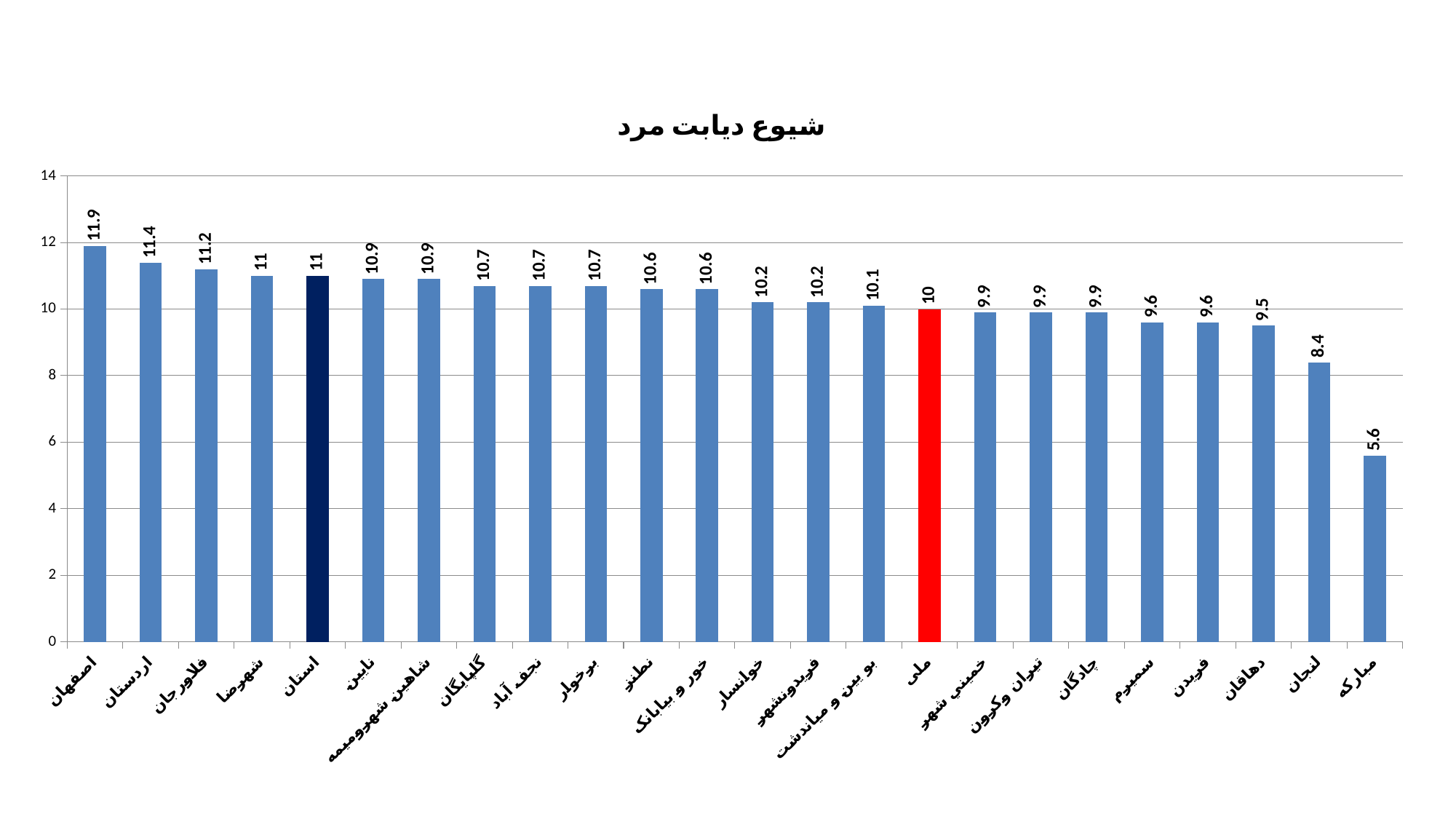
What is the value for ملی? 10 Which category has the lowest value? مبارکه What is the value for اصفهان? 11.9 What is the title of the chart? شیوع دیابت مرد Which category has the highest value? اصفهان What is the value for مبارکه? 5.6 What kind of chart is this? Bar chart What is the value for لنجان? 8.4 How many categories are shown on the chart? 24 What is the difference between the values for اصفهان and مبارکه? 6.3 Which is larger, the value for اردستان or the value for دهاقان? اردستان What is the difference between the values for استان and ملی? 1